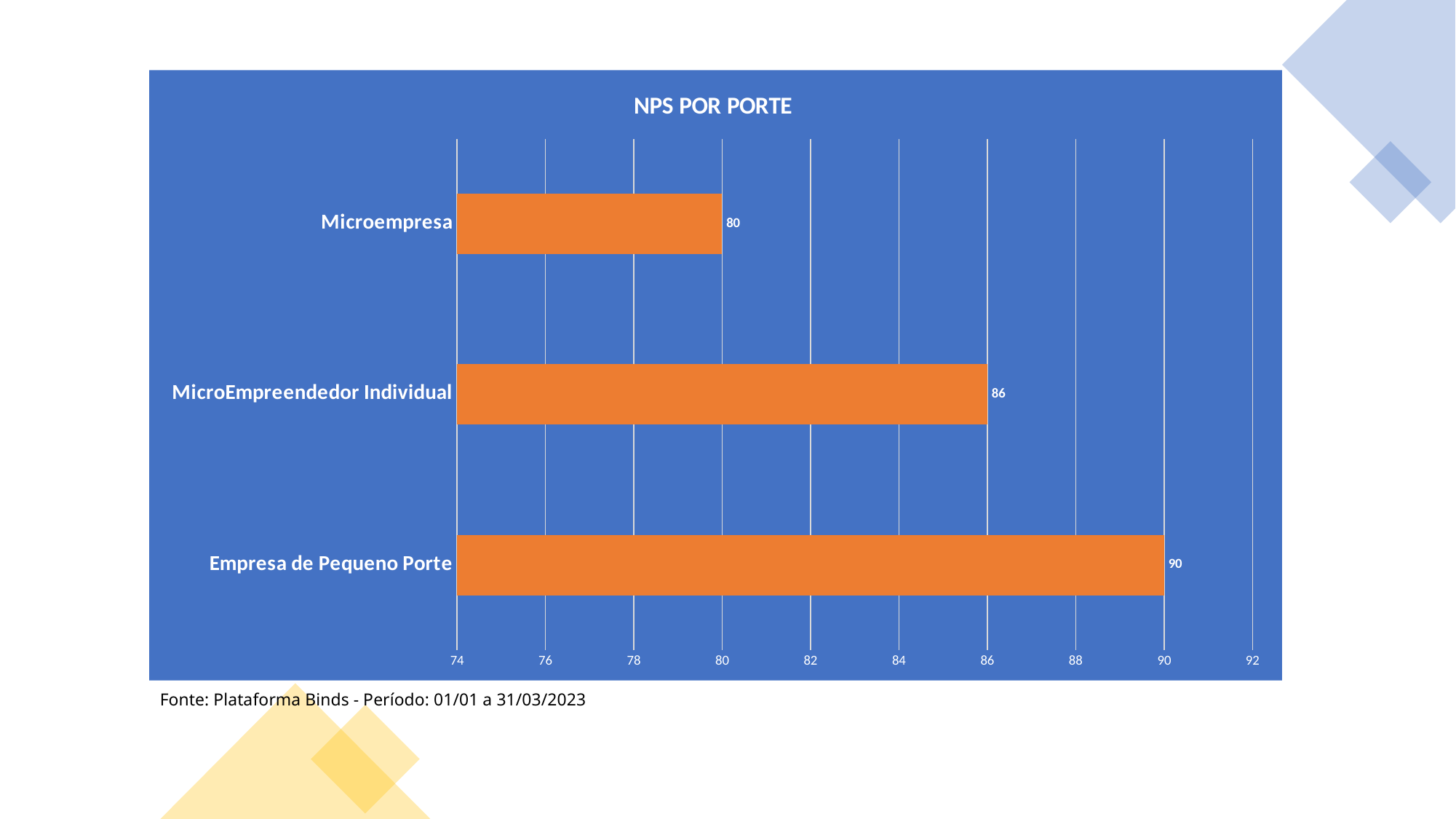
Which has a higher NPS, MicroEmpreendedor Individual or Microempresa? MicroEmpreendedor Individual What is the difference between the NPS of MicroEmpreendedor Individual and Microempresa? 6 Is the NPS for MicroEmpreendedor Individual greater or less than 84? greater What is the difference between the NPS of Empresa de Pequeno Porte and Microempresa? 10 What is the NPS value for Microempresa? 80 What kind of chart is shown on the slide? Bar chart How many categories are shown in the chart? 3 What is the NPS value for Empresa de Pequeno Porte? 90 What is the title of the chart? NPS POR PORTE Which category has the highest NPS? Empresa de Pequeno Porte What is the NPS value for MicroEmpreendedor Individual? 86 Which category has the lowest NPS? Microempresa